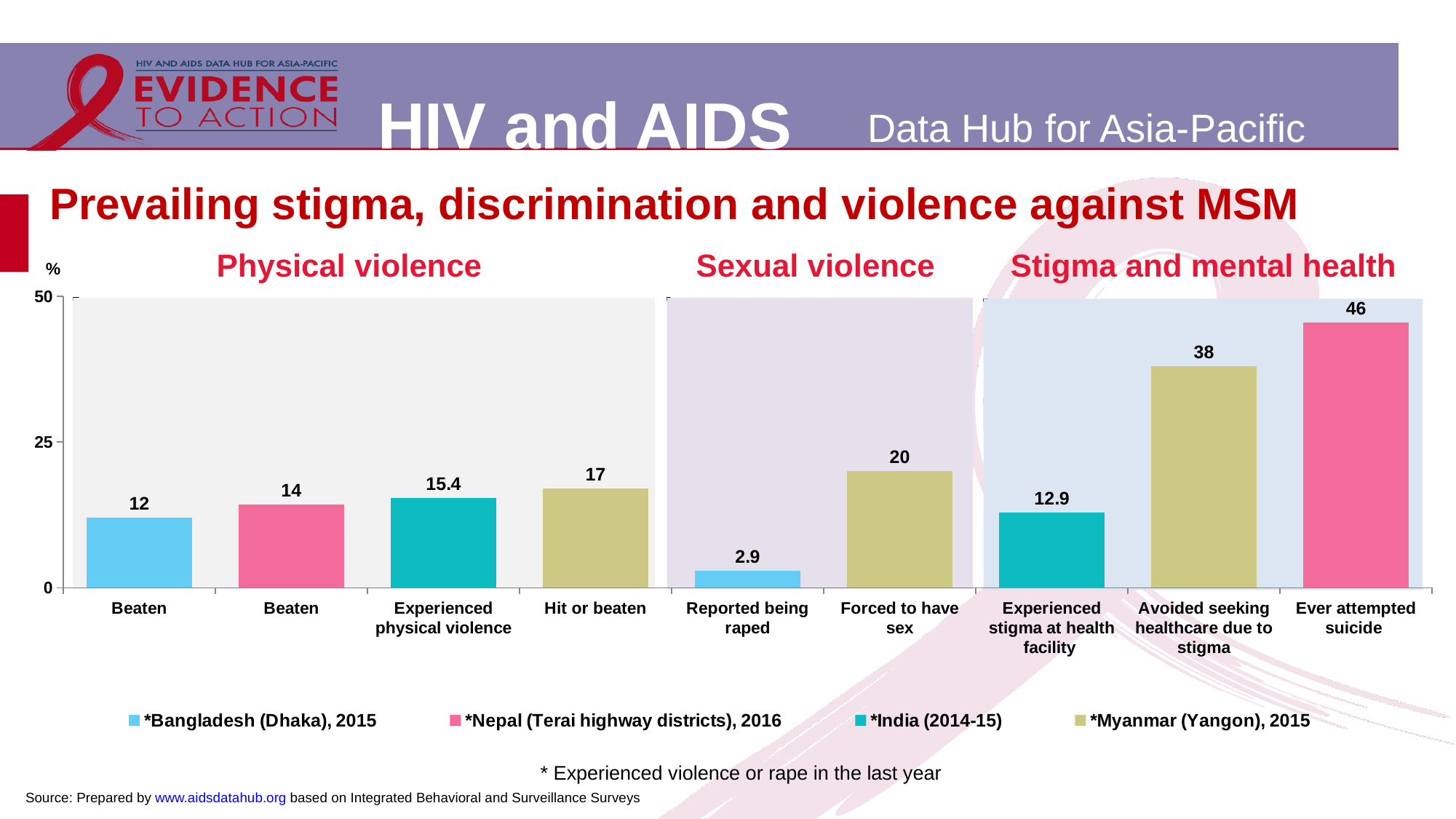
Which is larger: 'Forced to have sex' or 'Hit or beaten'? Forced to have sex Which category has the lowest value on the chart? Reported being raped What is the value for 'Reported being raped' in the Sexual violence section? 2.9 Which legend entry is represented by the light blue bars? *Bangladesh (Dhaka), 2015 What is the value for 'Ever attempted suicide' in the Stigma and mental health section? 46 Is the value for 'Avoided seeking healthcare due to stigma' greater or less than 25? greater What is the difference between 'Avoided seeking healthcare due to stigma' and 'Experienced stigma at health facility'? 25.1 What is the value for 'Experienced stigma at health facility'? 12.9 How many series does the legend list? 4 What kind of chart is shown on the slide? Bar chart Which category has the highest value on the chart? Ever attempted suicide What is the value for 'Hit or beaten' in the Physical violence section? 17